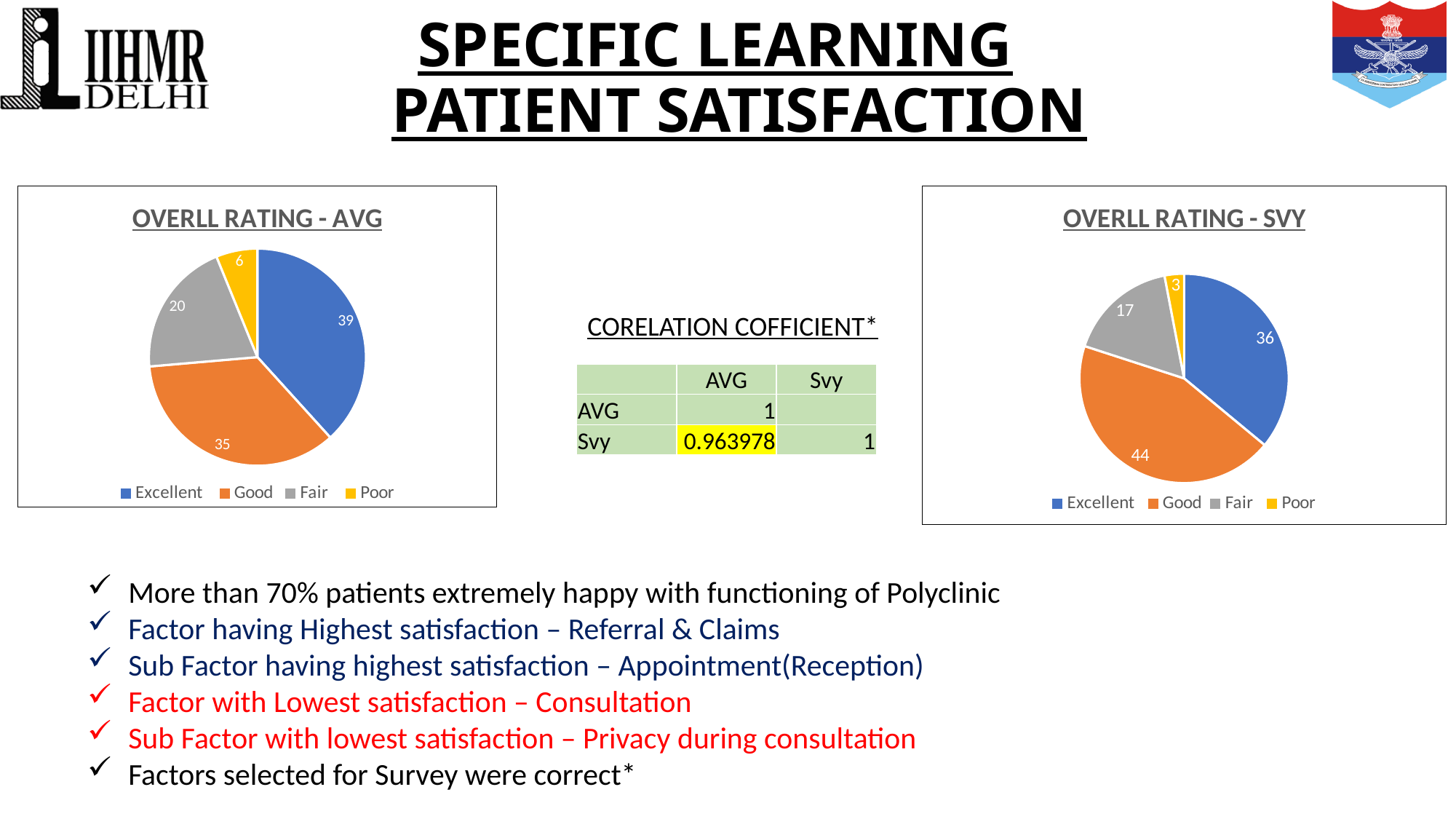
In the OVERLL RATING - AVG chart, which colour represents the Poor category? Yellow In the OVERLL RATING - SVY chart, what is the value for Good? 44 How many categories does the OVERLL RATING - AVG chart show? 4 In the OVERLL RATING - SVY chart, which category has the largest slice? Good In the OVERLL RATING - AVG chart, what is the value for Fair? 20 In the OVERLL RATING - SVY chart, what is the difference between the Fair and Poor values? 14 In the OVERLL RATING - AVG chart, what is the value for Excellent? 39 In the OVERLL RATING - SVY chart, which is larger, Excellent or Good? Good In the OVERLL RATING - AVG chart, which category has the smallest slice? Poor In the OVERLL RATING - SVY chart, what share of the total does the Good slice represent? 44% In the OVERLL RATING - AVG chart, what is the difference between the Excellent and Good values? 4 What kind of chart is the OVERLL RATING - SVY chart? Pie chart